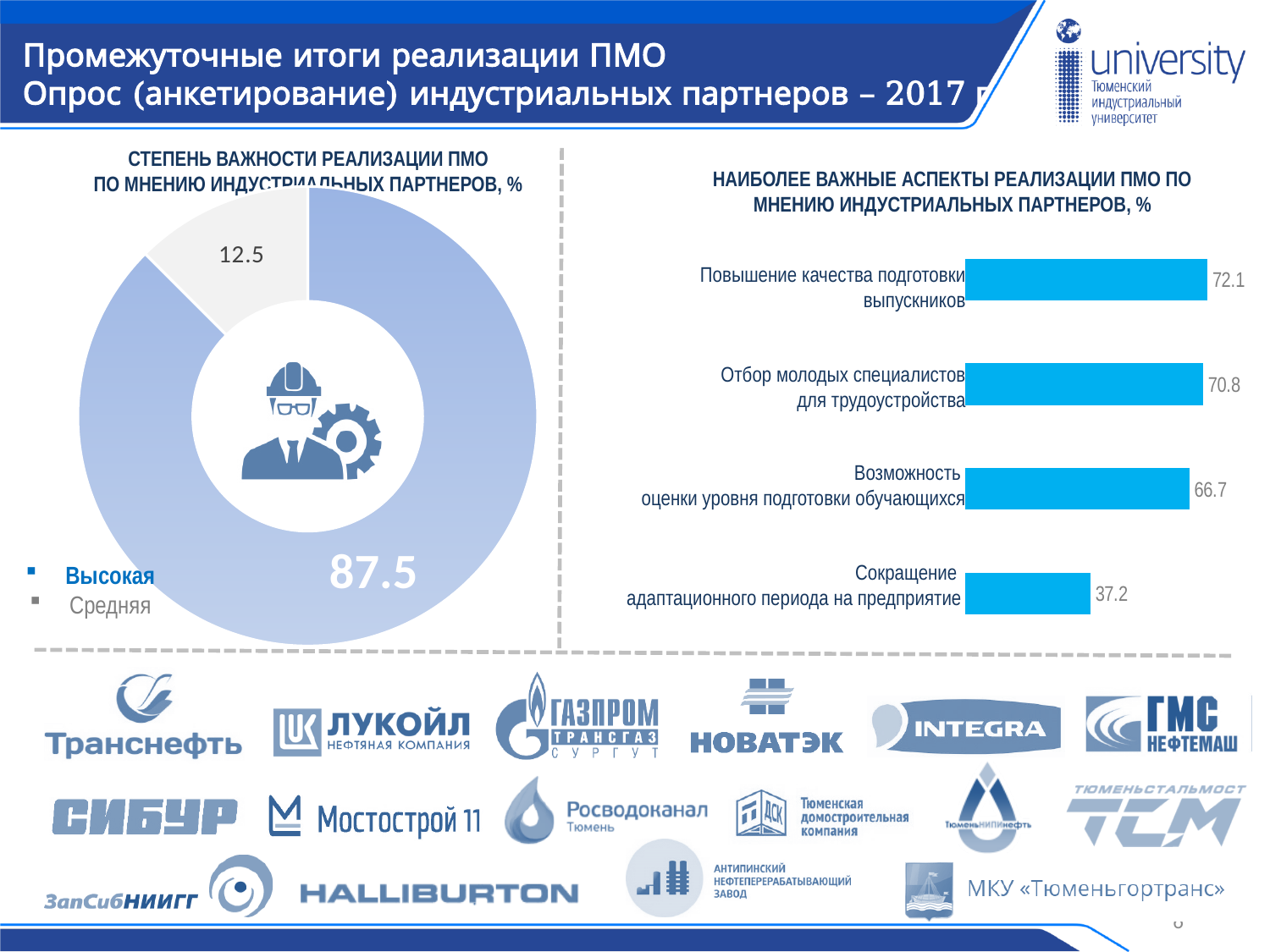
In the right chart (Наиболее важные аспекты реализации ПМО), what is the difference between 'Отбор молодых специалистов для трудоустройства' and 'Возможность оценки уровня подготовки обучающихся'? 4.1 In the right chart (Наиболее важные аспекты реализации ПМО), which aspect has the lowest value? Сокращение адаптационного периода на предприятие In the left chart (Степень важности реализации ПМО), what value is shown for 'Средняя'? 12.5 How many categories does the legend of the left chart (Степень важности реализации ПМО) list? 2 In the left chart (Степень важности реализации ПМО), what percentage of industrial partners rated the importance as 'Высокая'? 87.5 In the left chart (Степень важности реализации ПМО), what is the difference between the 'Высокая' and 'Средняя' values? 75 In the left chart (Степень важности реализации ПМО), which category has the larger share: 'Высокая' or 'Средняя'? Высокая What type of chart is the left chart (Степень важности реализации ПМО)? Pie (doughnut) chart In the right chart (Наиболее важные аспекты реализации ПМО), which aspect has the highest value? Повышение качества подготовки выпускников In the right chart (Наиболее важные аспекты реализации ПМО), what is the value for 'Повышение качества подготовки выпускников'? 72.1 In the right chart (Наиболее важные аспекты реализации ПМО), what is the value for 'Сокращение адаптационного периода на предприятие'? 37.2 How many bars are shown in the right chart (Наиболее важные аспекты реализации ПМО)? 4